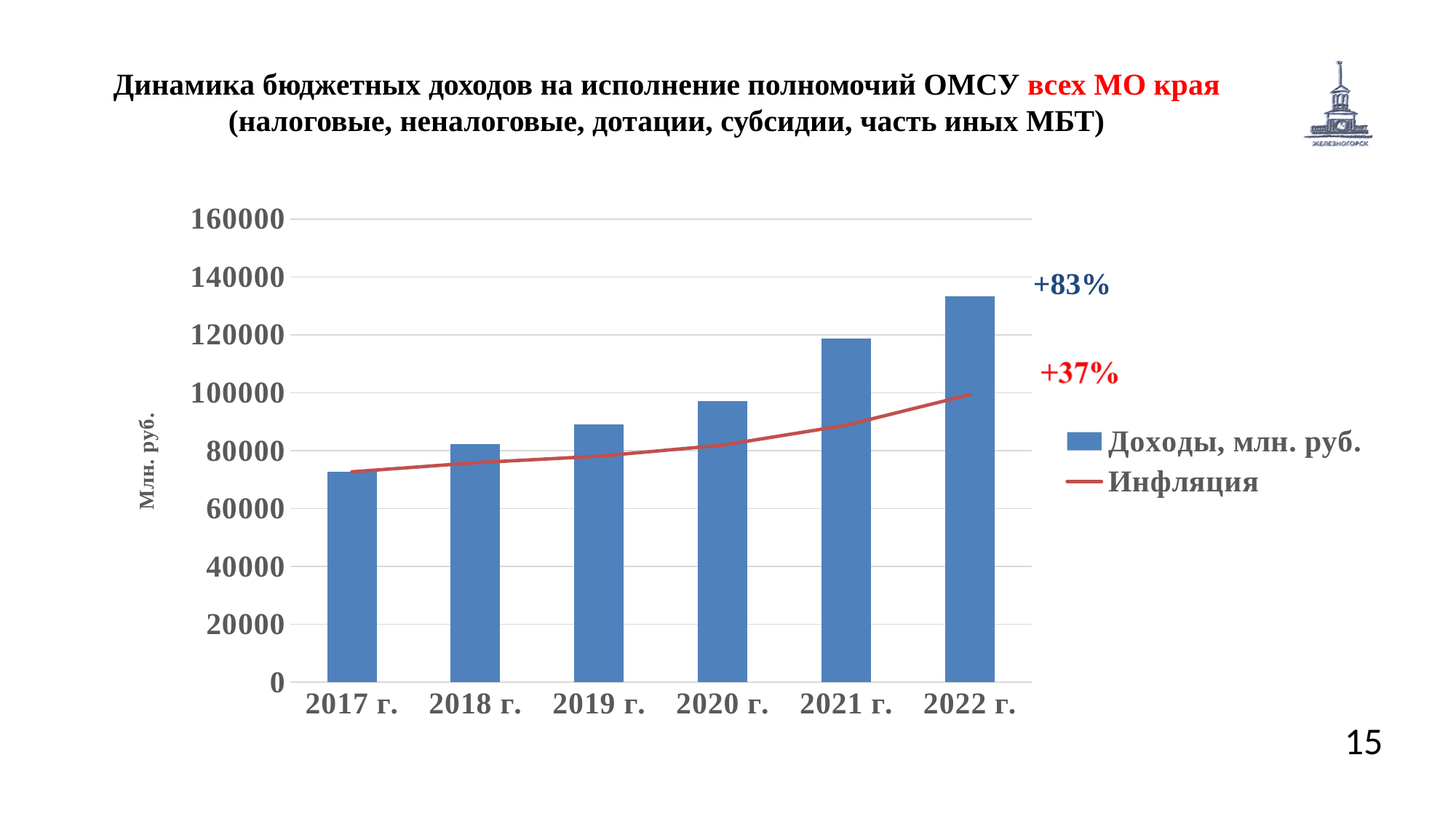
Which year has the lowest value for Доходы, млн. руб.? 2017 г. Is the value for Доходы, млн. руб. in 2021 г. greater or less than 100000? greater Is the value for Доходы, млн. руб. in 2022 г. greater or less than 120000? greater Which is larger, the value for Доходы, млн. руб. in 2019 г. or in 2021 г.? 2021 г. Do the values for Доходы, млн. руб. rise or fall from 2017 г. to 2022 г.? Rise Is the value for Доходы, млн. руб. in 2017 г. greater or less than 80000? less How many years are shown on the x axis of the chart? 6 Which year has the highest value for Доходы, млн. руб.? 2022 г. What kind of chart is shown on the slide? Bar chart with a line What is the label of the line series in the legend? Инфляция How many series does the chart legend list? 2 What percentage growth is annotated next to the Доходы bars in blue? +83%